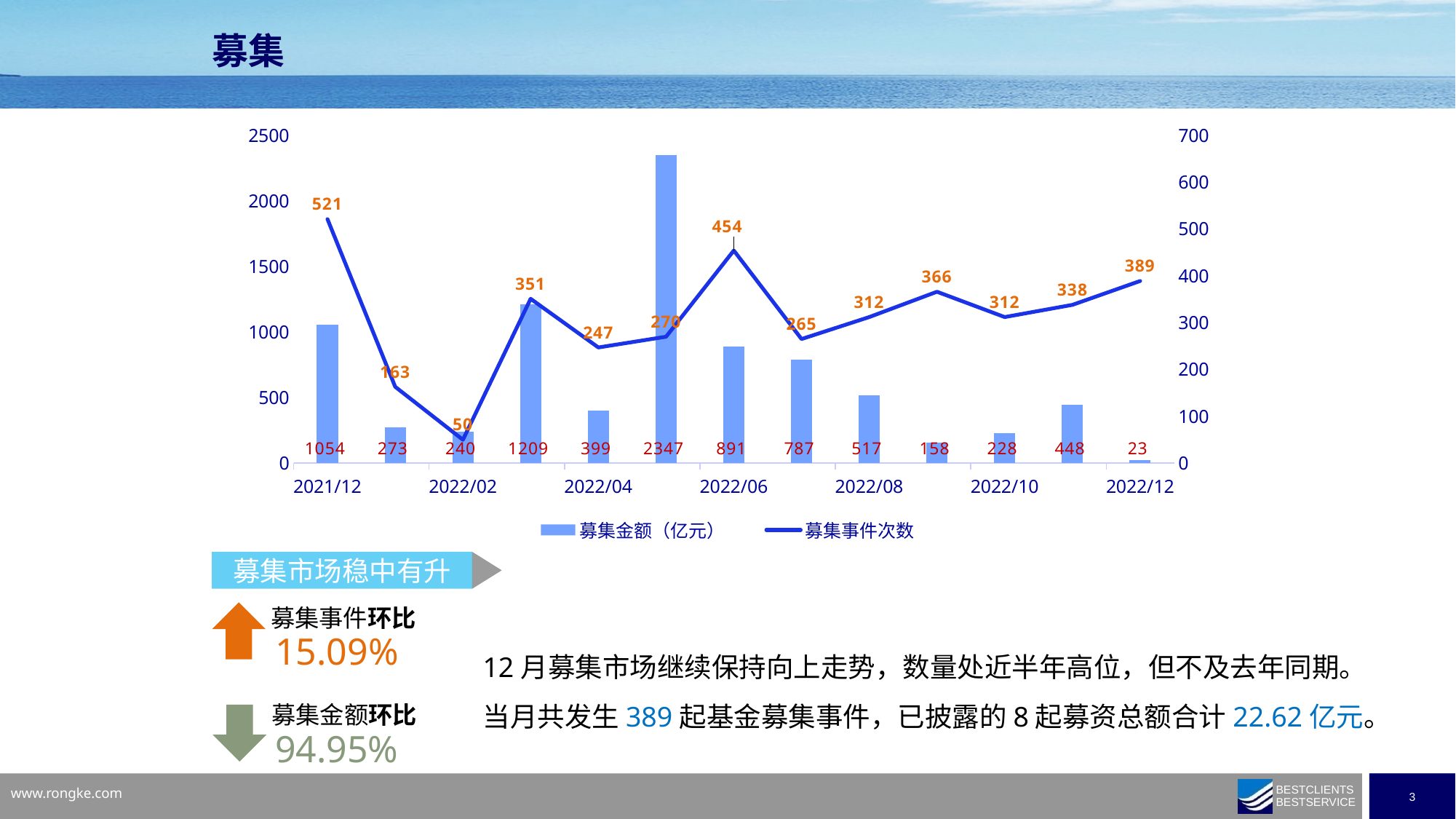
What is the 募集事件次数 value for 2022/12? 389 How many series does the legend list? 2 What is the 募集事件次数 value for 2021/12? 521 What is the 募集金额（亿元） value for 2022/06? 891 Which is larger, the 募集金额（亿元） value for 2022/04 or for 2022/08? 2022/08 What is the difference between the 募集金额（亿元） values for 2021/12 and 2022/12? 1031 Which month has the highest 募集金额（亿元） bar? 2022/05 How many months are plotted on the x axis? 13 Which month has the lowest 募集事件次数 value? 2022/02 What kind of chart is shown on the slide? Combined bar and line chart Which is larger, the 募集事件次数 value for 2022/08 or for 2022/10? They are equal (312) Which series is drawn as a line? 募集事件次数